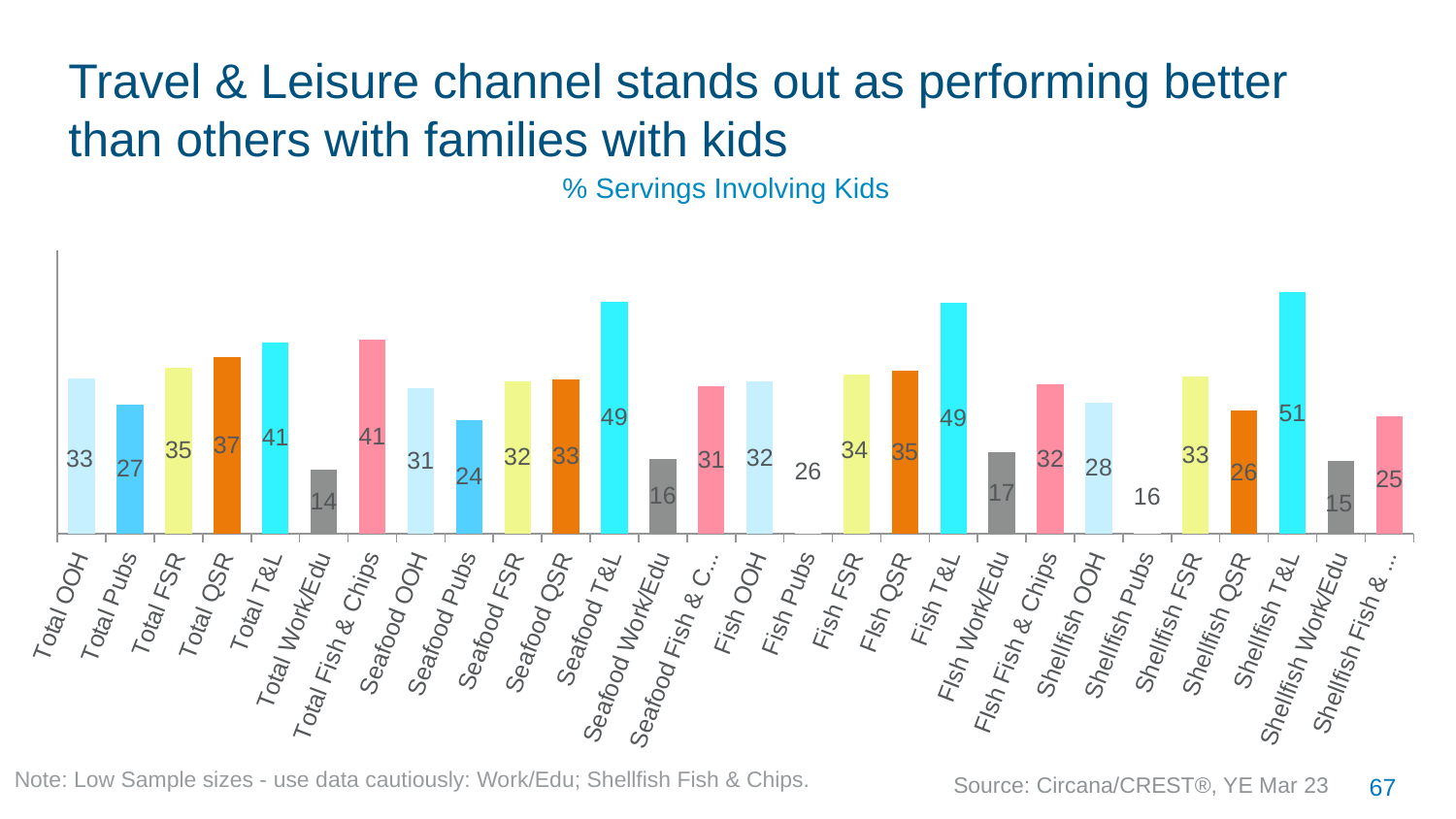
Which category has the lowest value? Total Work/Edu What is the difference between the values for Shellfish T&L and Shellfish Work/Edu? 36 What is the value for Total T&L? 41 What is the title of the chart? % Servings Involving Kids What is the value for Seafood QSR? 33 What is the difference between the values for Seafood T&L and Seafood OOH? 18 How many categories are shown on the x axis? 28 Which category has the highest value? Shellfish T&L Which is larger, Total QSR or Total FSR? Total QSR What kind of chart is shown? bar chart Which is larger, Fish T&L or Fish QSR? Fish T&L What is the value for Fish Work/Edu? 17